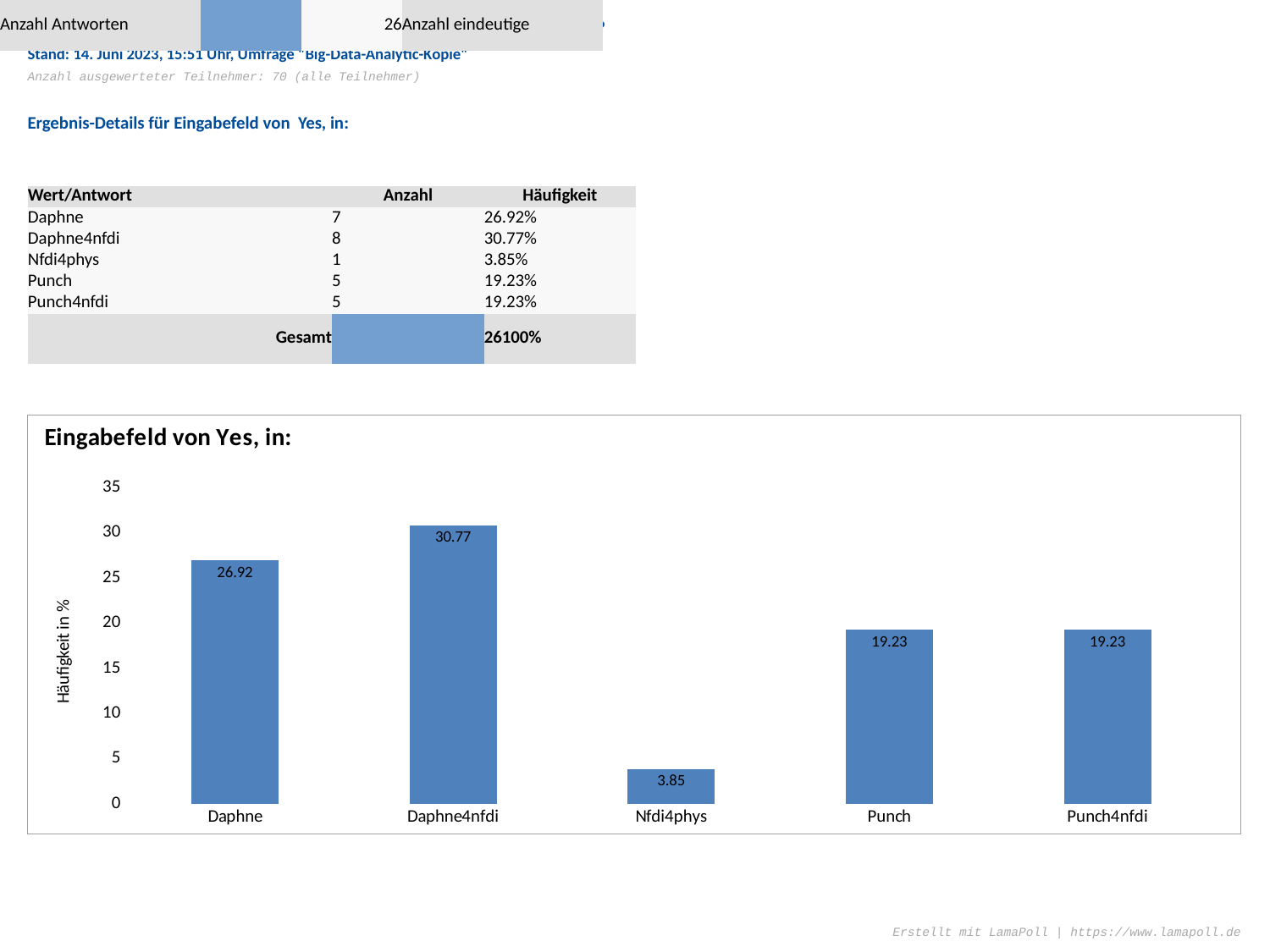
Which category has the highest value in the chart? Daphne4nfdi What is the value for Daphne4nfdi in the chart? 30.77 How many categories are shown on the x axis of the chart? 5 What is the difference between the values for Punch and Nfdi4phys? 15.38 Is the value for Punch4nfdi greater or less than 20? less What kind of chart is shown on the slide? bar chart Which category has the lowest value in the chart? Nfdi4phys What is the value for Daphne in the chart? 26.92 Which is larger, the value for Daphne or the value for Punch? Daphne What is the difference between the values for Daphne4nfdi and Daphne? 3.85 What is the value for Nfdi4phys in the chart? 3.85 What is the label of the y axis of the chart? Häufigkeit in %